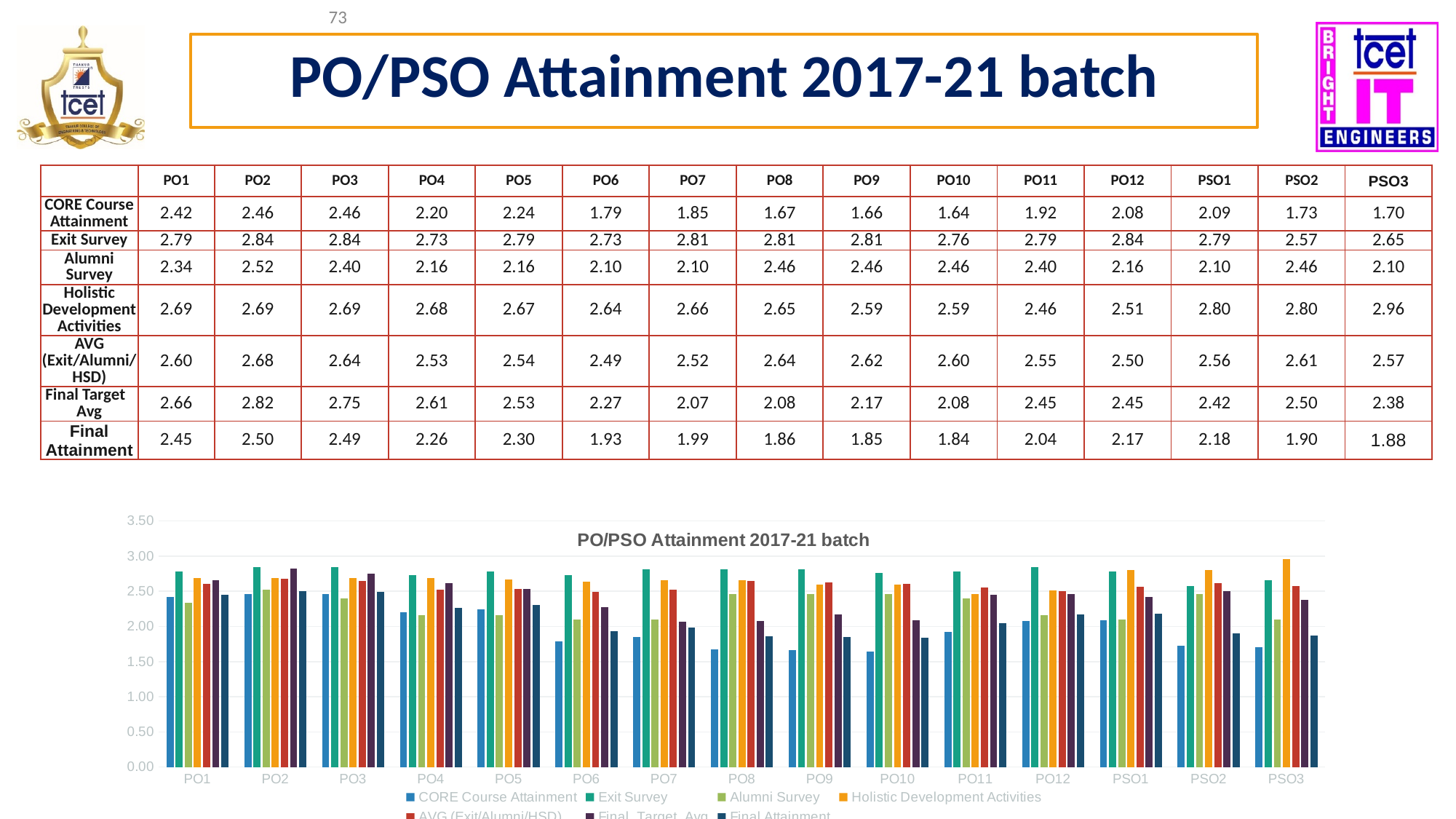
What kind of chart is shown on the slide? Bar chart What is the title of the chart? PO/PSO Attainment 2017-21 batch For which category is the Holistic Development Activities bar the highest? PSO3 For which category is the Exit Survey bar the lowest? PSO2 For PO2, which is larger: the Exit Survey value or the Alumni Survey value? Exit Survey What is the Exit Survey value for PO1? 2.79 How many series does the chart legend list? 7 How many categories (PO/PSO) are plotted along the x axis of the chart? 15 Does the CORE Course Attainment value generally rise or fall from PO1 to PO10? fall What is the Holistic Development Activities value for PSO3? 2.96 Is the CORE Course Attainment value for PO8 greater or less than 2.00? less What is the difference between the Exit Survey value and the CORE Course Attainment value for PO1? 0.37